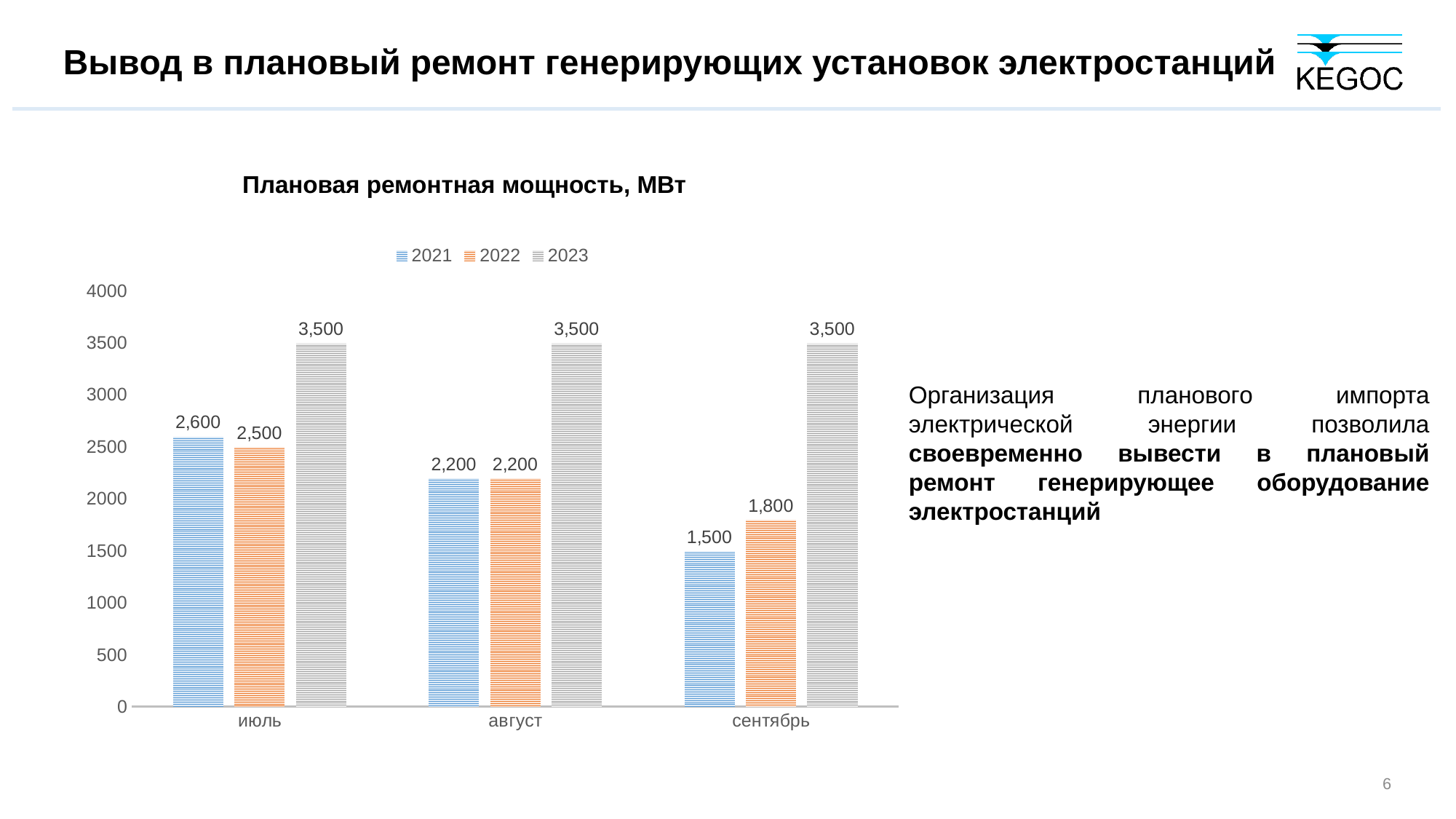
Which month has the lowest value for the 2021 series? сентябрь Which is larger in сентябрь, the 2021 value or the 2022 value? 2022 What is the difference between the 2021 and 2022 values in июль? 100 How many series does the legend list? 3 How many months are shown on the x axis? 3 What is the value for 2023 in август? 3,500 What kind of chart is shown on the slide? Bar chart Which month has the highest value for the 2022 series? июль What is the value for 2021 in июль? 2,600 Do the values for the 2021 series rise or fall from июль to сентябрь? Fall What is the difference between the 2023 and 2021 values in сентябрь? 2,000 What is the value for 2022 in сентябрь? 1,800